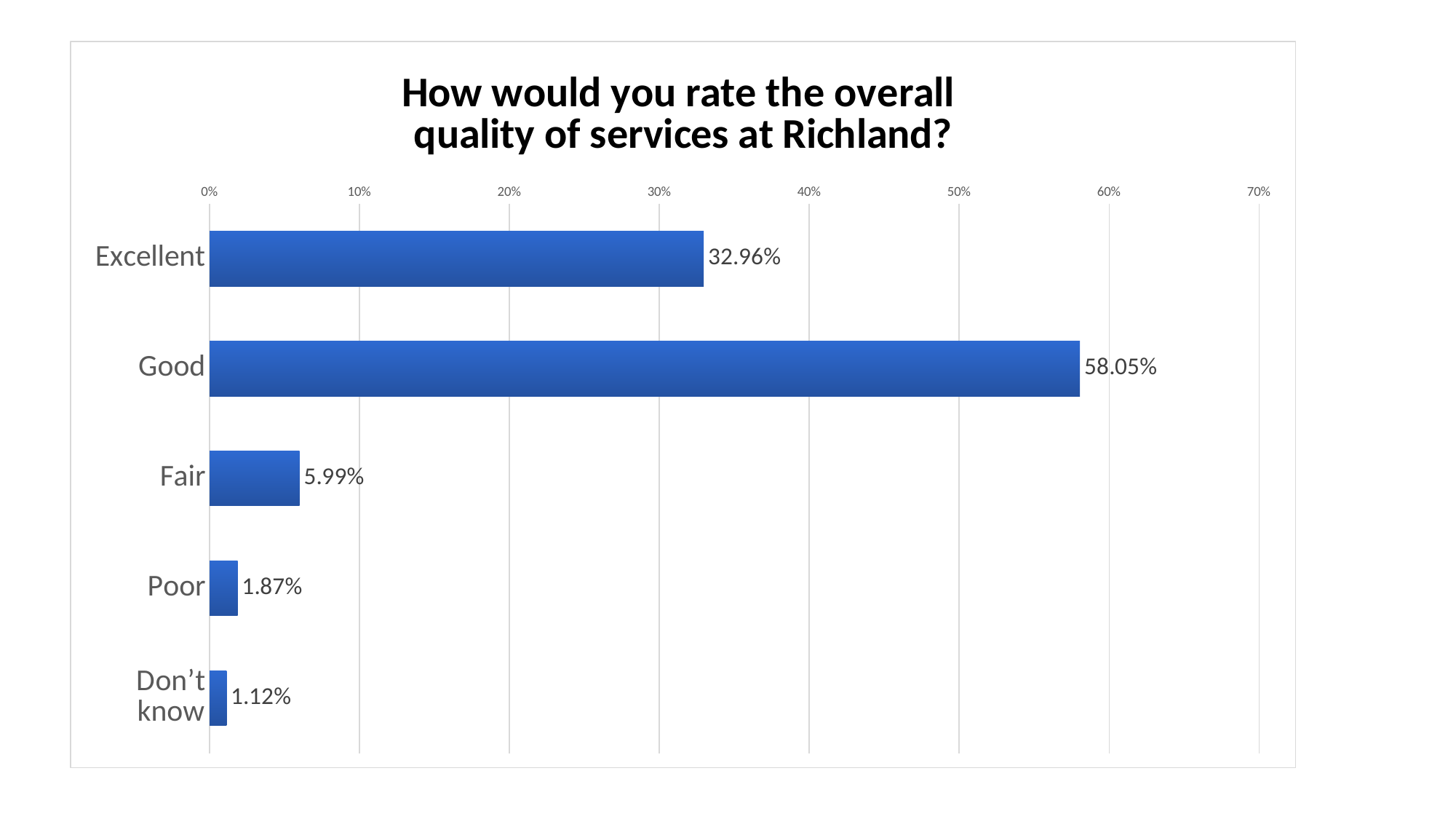
Which is larger, the value for Fair or the value for Poor? Fair What percentage of respondents rated the overall quality of services at Richland as Excellent? 32.96% Is the value for Excellent greater or less than 30%? greater Which rating category has the lowest value? Don't know What kind of chart is shown on the slide? Bar chart What is the value shown for the Good category? 58.05% Which rating category has the highest value? Good What is the title of the chart? How would you rate the overall quality of services at Richland? What is the value for the Don't know category? 1.12% How many rating categories are shown in the chart? 5 What percentage of respondents rated the services as Fair? 5.99% What is the difference between the Good and Excellent values? 25.09%